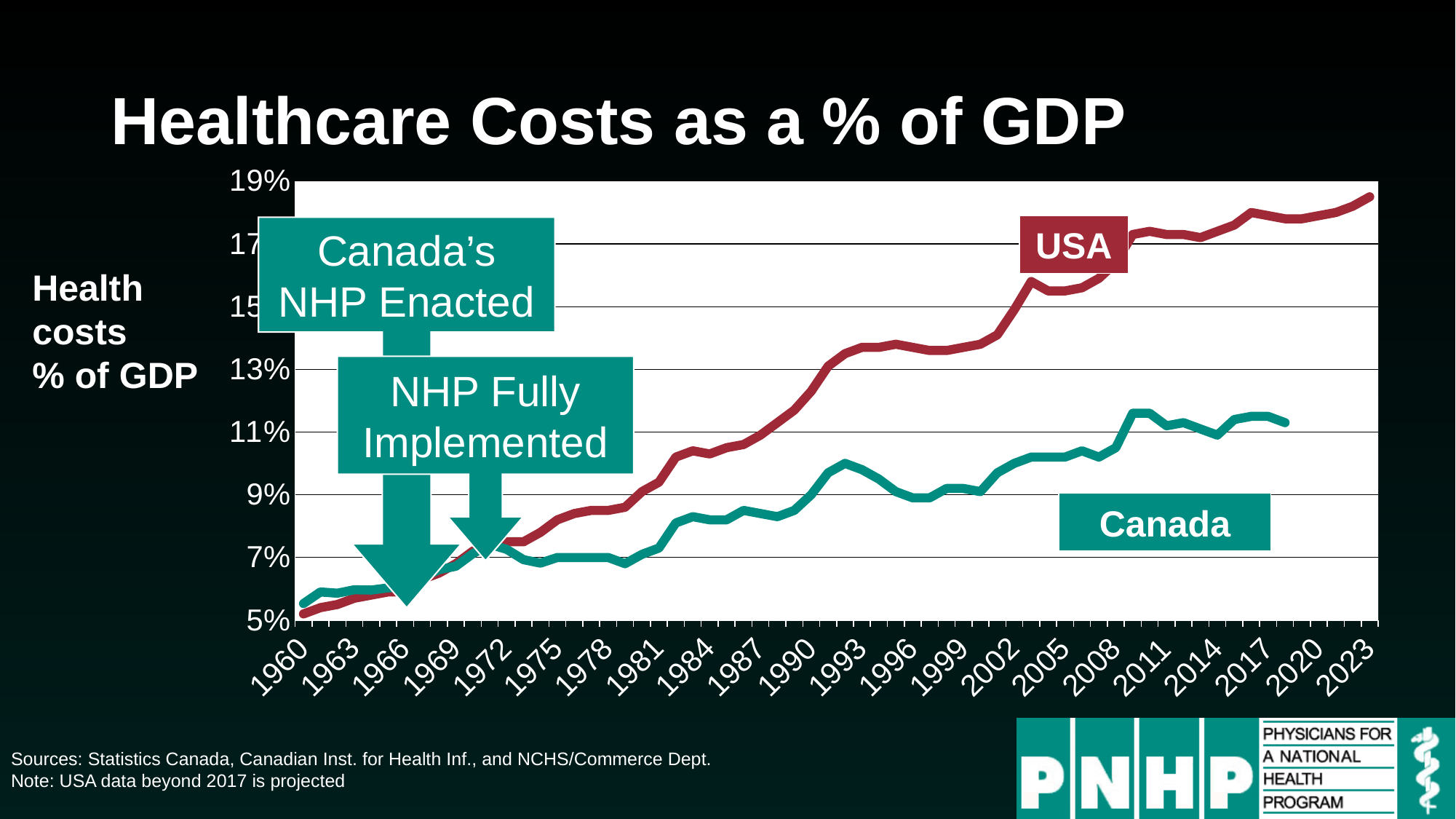
In 2017, which series has the higher value, USA or Canada? USA Is the value for the USA in 1993 greater or less than 13%? greater Which series is drawn in red? USA Does the USA line generally rise or fall from 1960 to 2023? rise What is the title of the chart? Healthcare Costs as a % of GDP Is the value for the USA in 2023 greater or less than 17%? greater What kind of chart is shown on the slide? line chart In 1990, which series has the higher value, USA or Canada? USA Is the value for the USA in 1960 greater or less than 7%? less How many series are plotted on the chart? 2